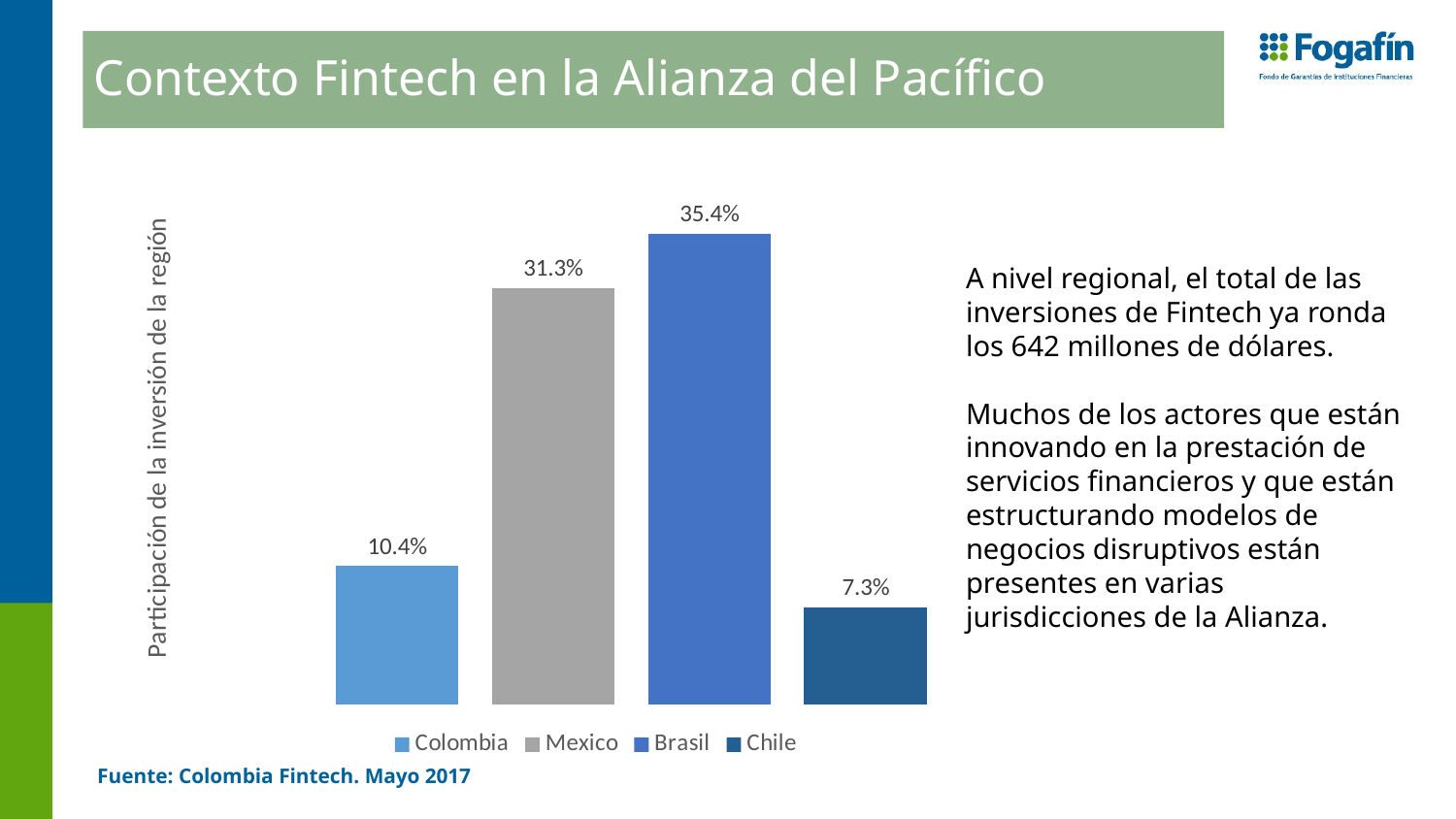
What is the difference between the values for Brasil and Mexico? 4.1% Which country has the lowest share of investment in the region? Chile What is the value for Brasil? 35.4% What is the label on the vertical axis of the chart? Participación de la inversión de la región Which is larger, the value for Colombia or the value for Mexico? Mexico What is the value for Mexico? 31.3% How many countries are shown in the chart? 4 What is the value for Colombia? 10.4% What is the difference between the values for Colombia and Chile? 3.1% Which country has the highest share of investment in the region? Brasil What kind of chart is shown on the slide? Bar chart What is the value for Chile? 7.3%